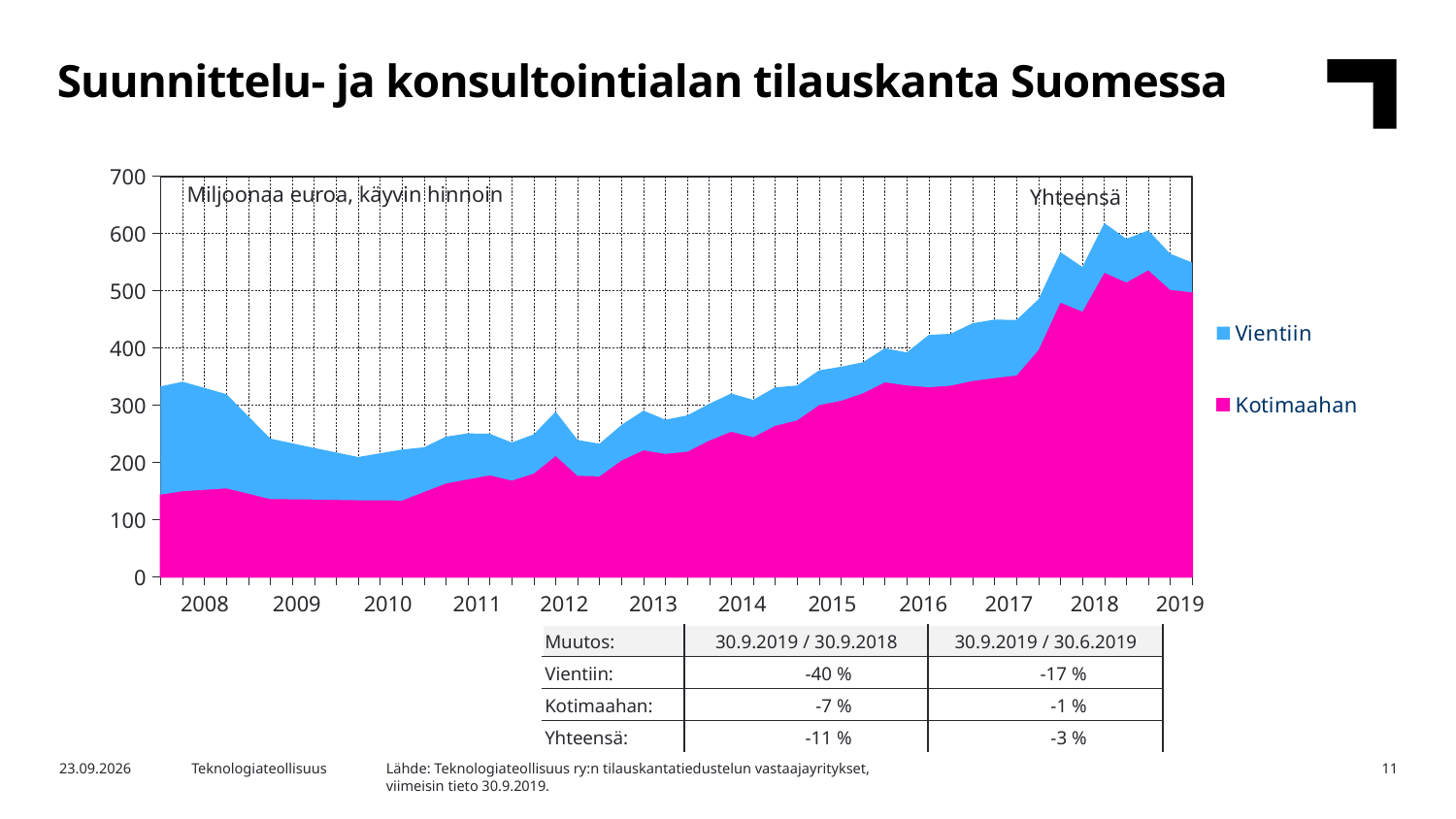
According to the table below the chart, what is the change in Vientiin for 30.9.2019 / 30.9.2018? -40 % Which two series are listed in the chart legend? Vientiin and Kotimaahan How many year labels are shown on the x axis? 12 What kind of chart is shown on the slide? Stacked area chart Is the total (Yhteensä) value at the end of 2019 greater or less than 600? less Is the total (Yhteensä) value in 2010 greater or less than 300? less Is the total (Yhteensä) value at the start of 2008 greater or less than 300? greater What unit is stated in the chart's plot area label? Miljoonaa euroa, käyvin hinnoin How many series does the chart legend list? 2 Does the total (Yhteensä) order book generally rise or fall from 2010 to 2018? Rise